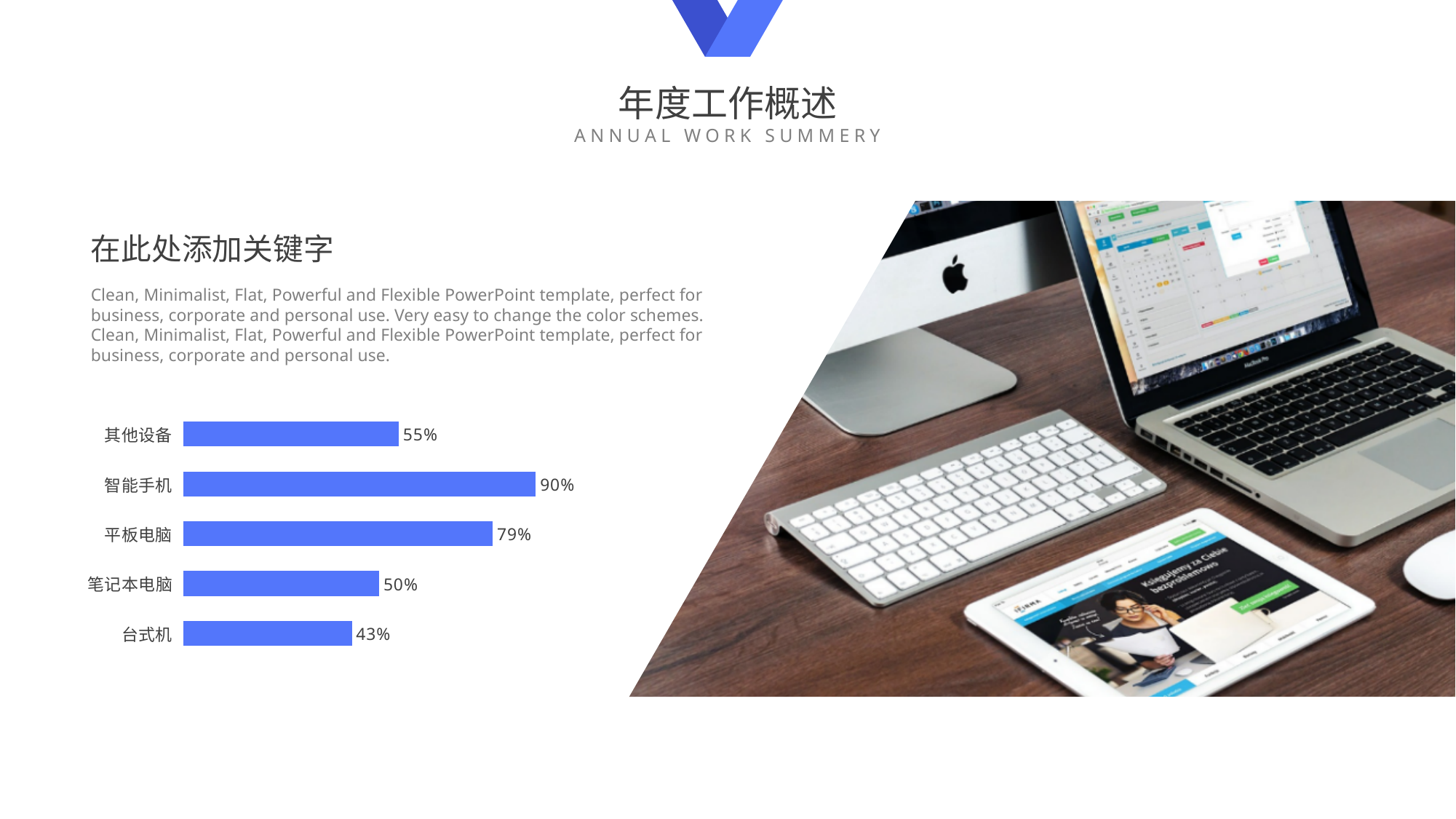
What is the value for 平板电脑? 79% How many categories are shown in the chart? 5 What is the value for 台式机? 43% Which category has the lowest value? 台式机 What is the value for 笔记本电脑? 50% Which is larger, the value for 其他设备 or the value for 台式机? 其他设备 What kind of chart is shown on the slide? Bar chart What is the difference between the values for 智能手机 and 平板电脑? 11% What is the value for 智能手机? 90% Which category has the highest value? 智能手机 What colour are the bars in the chart? Blue What is the difference between the values for 其他设备 and 笔记本电脑? 5%